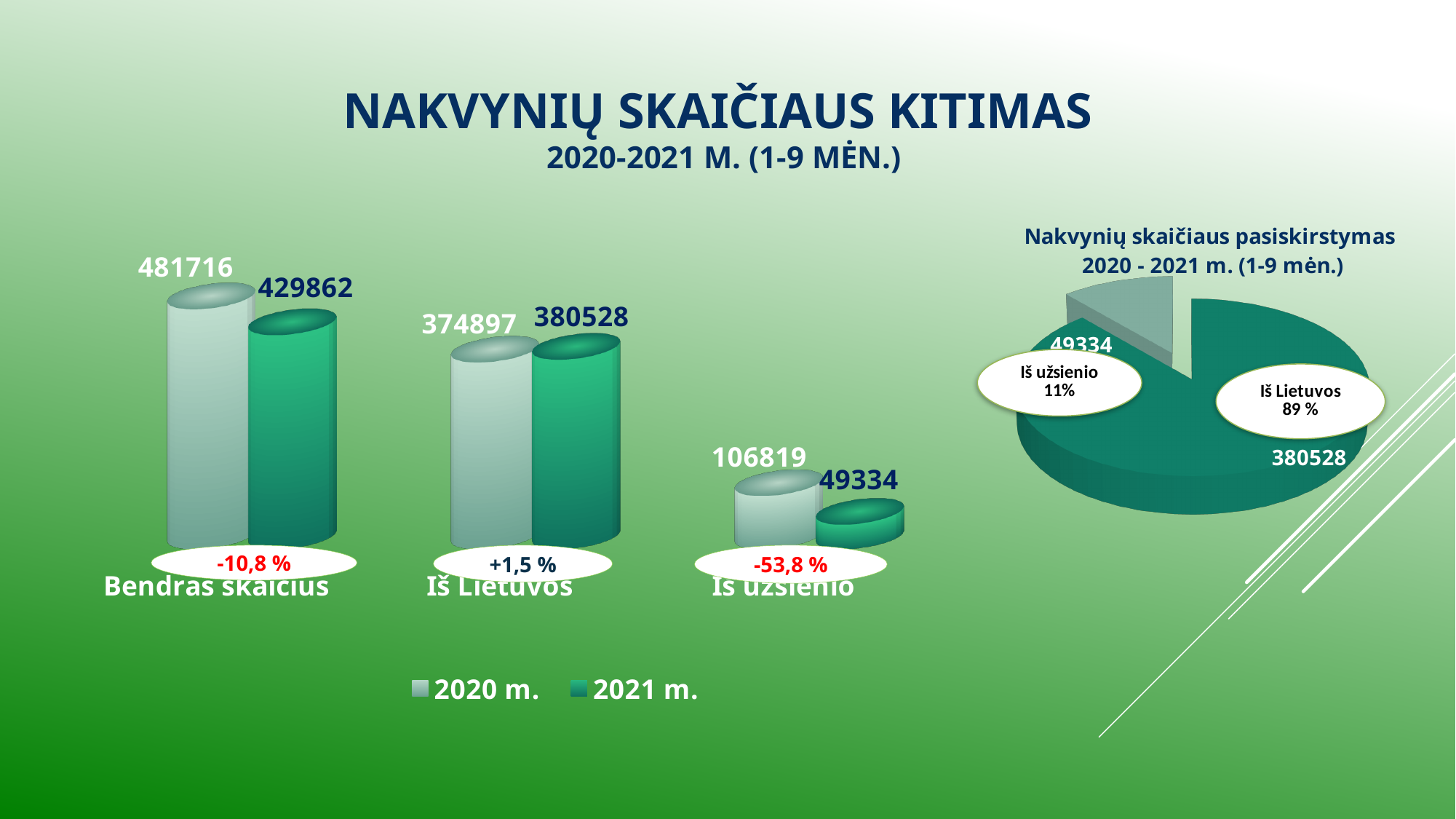
In the bar chart on the left, what is the value for Bendras skaičius in 2020 m.? 481716 How many series does the legend of the bar chart on the left list? 2 In the bar chart on the left, which category has the highest value for 2020 m.? Bendras skaičius In the bar chart on the left, what is the difference between the 2020 m. and 2021 m. values for Iš užsienio? 57485 In the pie chart titled 'Nakvynių skaičiaus pasiskirstymas', what share does Iš užsienio have? 11% In the bar chart on the left, which is larger for Iš Lietuvos: the 2020 m. value or the 2021 m. value? 2021 m. In the bar chart on the left, what is the value for Iš užsienio in 2021 m.? 49334 In the bar chart on the left, what is the difference between the 2020 m. and 2021 m. values for Bendras skaičius? 51854 In the bar chart on the left, what is the value for Iš Lietuvos in 2021 m.? 380528 What kind of chart is the chart on the right of the slide? Pie chart In the bar chart on the left, which category has the lowest value for 2021 m.? Iš užsienio How many categories are shown in the bar chart on the left? 3